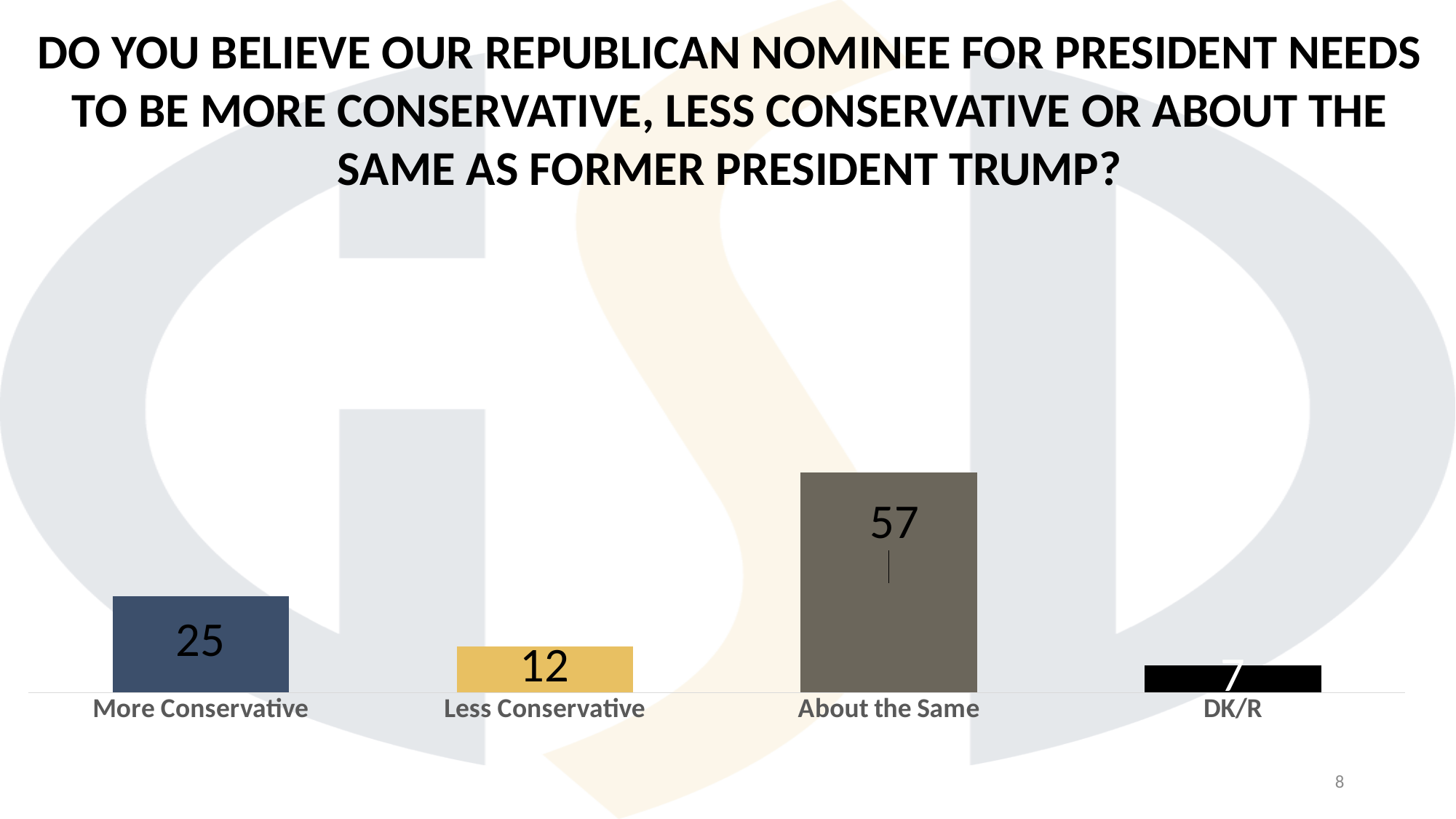
What kind of chart is shown on the slide? Bar chart How many categories are shown in the chart? 4 What is the value for Less Conservative? 12 What colour is the bar for Less Conservative? Yellow Which is larger, the value for More Conservative or the value for Less Conservative? More Conservative What is the value for About the Same? 57 Which category has the highest value? About the Same What is the value for More Conservative? 25 What is the difference between the values for About the Same and More Conservative? 32 Which category has the lowest value? DK/R What is the value for DK/R? 7 What is the difference between the values for More Conservative and Less Conservative? 13